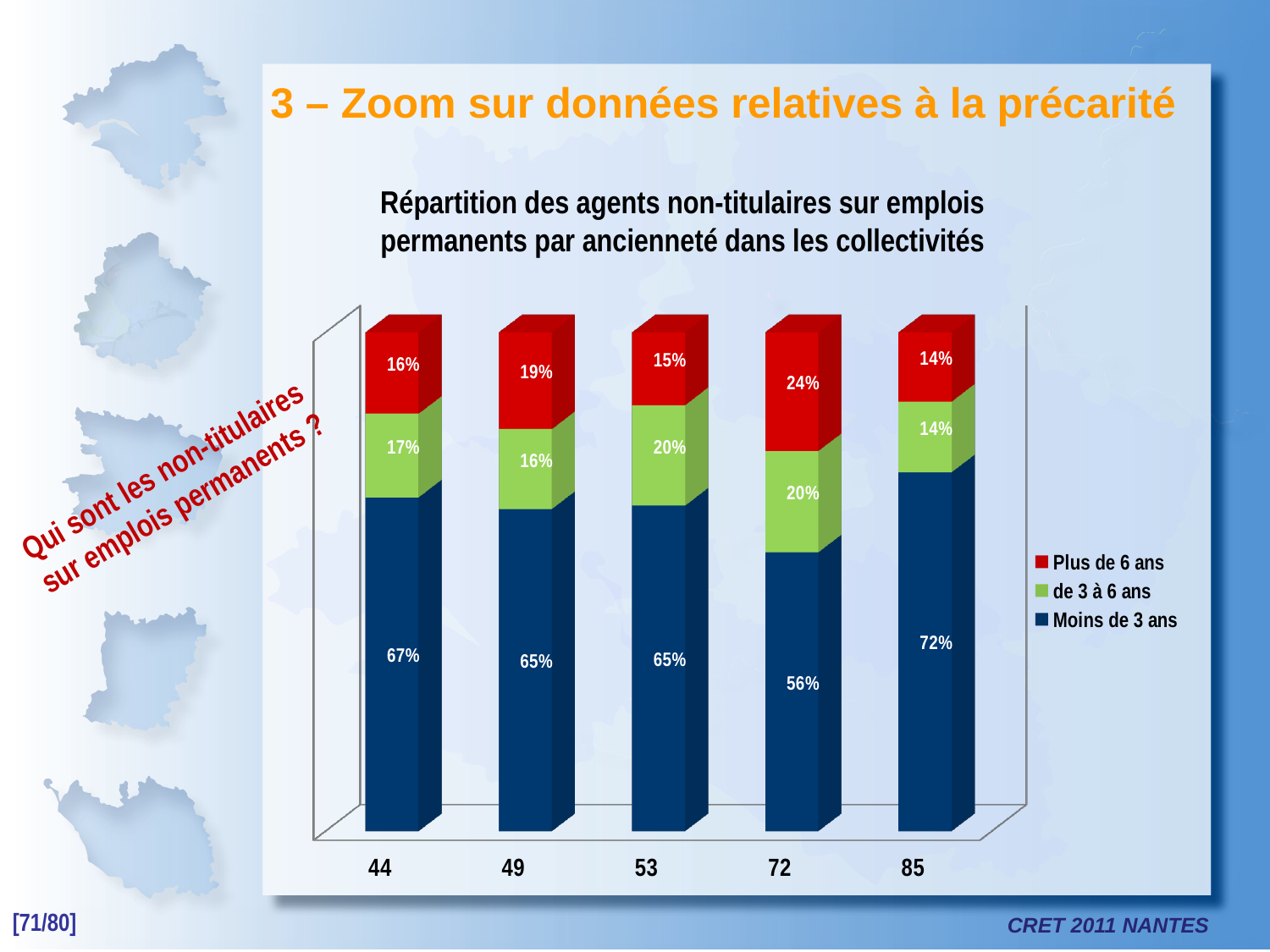
Which category has the lowest value for 'Plus de 6 ans'? 85 What kind of chart is shown on the slide? Stacked bar chart What is the value of 'de 3 à 6 ans' for category 85? 14% Is the 'de 3 à 6 ans' value larger for category 53 or for category 49? 53 What is the difference between the 'Moins de 3 ans' values for categories 85 and 72? 16% Which series is shown in red in the legend? Plus de 6 ans What is the value of 'Moins de 3 ans' for category 72? 56% What is the value of 'Plus de 6 ans' for category 49? 19% Which category has the highest value for 'Plus de 6 ans'? 72 Which category has the highest value for 'Moins de 3 ans'? 85 How many series does the legend list? 3 How many categories are shown on the x axis of the chart? 5